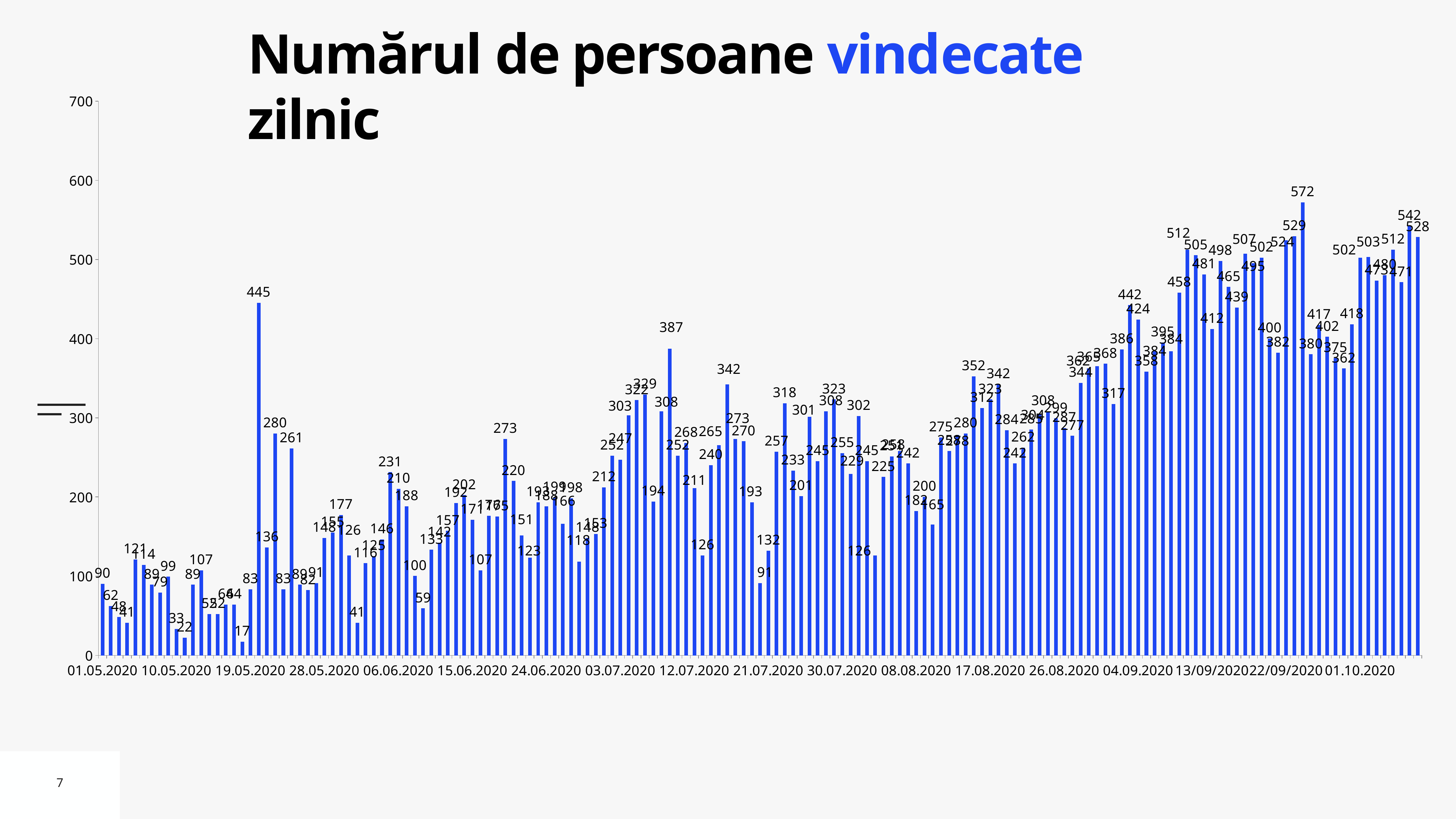
What colour are the bars in the chart? blue Which is larger, the peak bar in May labelled 445 or the peak bar in July labelled 387? 445 What is the value for 01.05.2020, the first bar in the chart? 90 Is the highest bar in the chart greater or less than 500? greater Is the value for 01.05.2020 greater or less than 100? less What is the highest daily value shown in the chart? 572 What is the lowest daily value shown in the chart? 17 What kind of chart is shown on the slide? bar chart What is the value of the last bar in the chart? 528 What is the difference between the highest value (572) and the last bar (528)? 44 What is the title of the chart? Numărul de persoane vindecate zilnic Do the values generally rise or fall from May to October along the x axis? rise